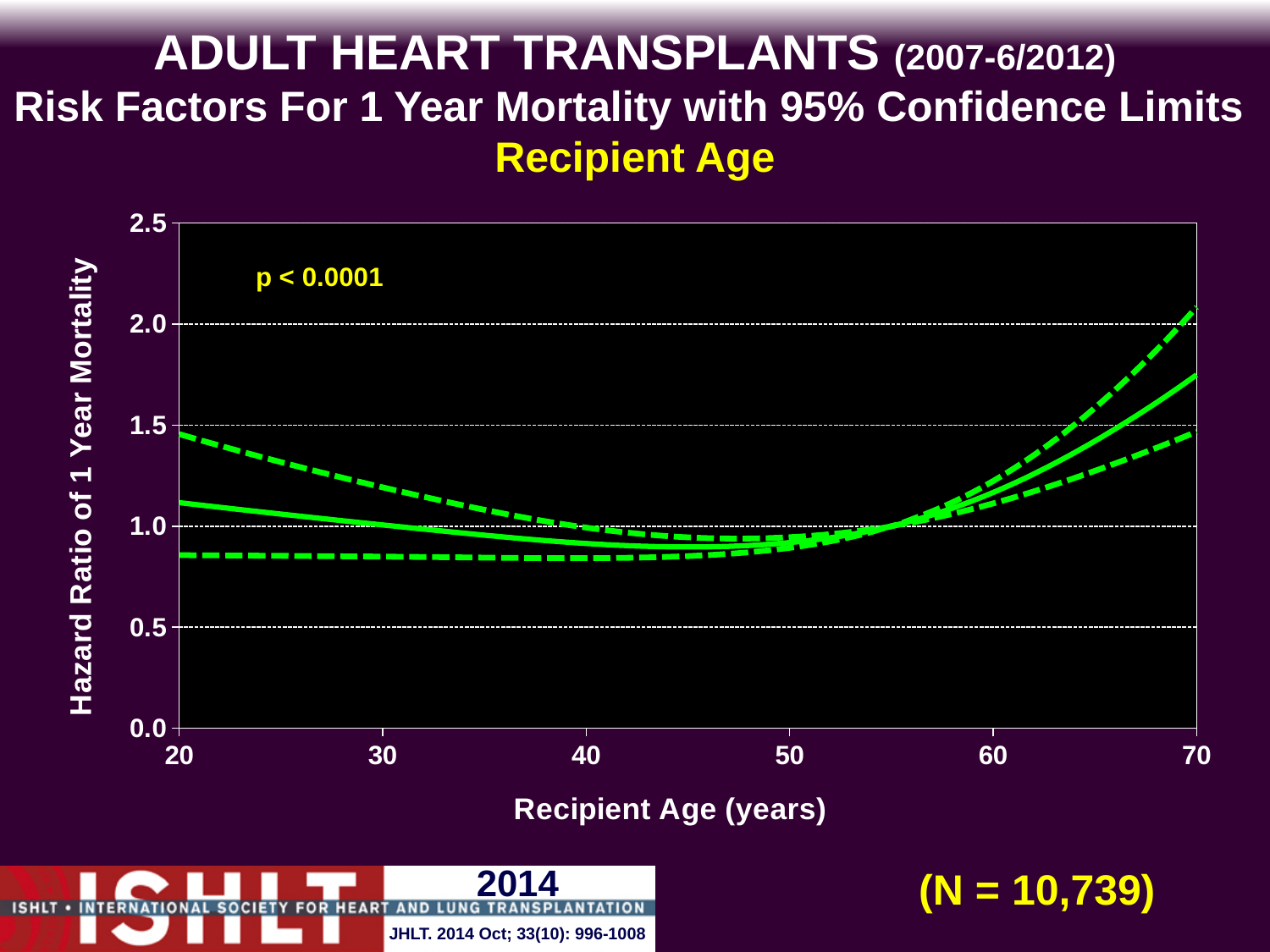
Is the hazard ratio (solid line) larger at recipient age 70 or at recipient age 20? 70 Is the hazard ratio (solid line) at recipient age 70 greater or less than 1.5? greater Does the solid hazard ratio line rise or fall as recipient age increases from 55 to 70 years? rise How many lines are plotted on the chart? 3 What sample size (N) is shown on the slide? N = 10,739 What p-value is printed on the chart? p < 0.0001 Is the lower confidence limit (lower dashed line) at recipient age 20 greater or less than 1.0? less Is the hazard ratio (solid line) at recipient age 45 greater or less than 1.0? less Does the solid hazard ratio line rise or fall as recipient age increases from 20 to 45 years? fall What kind of chart is shown on the slide? line chart